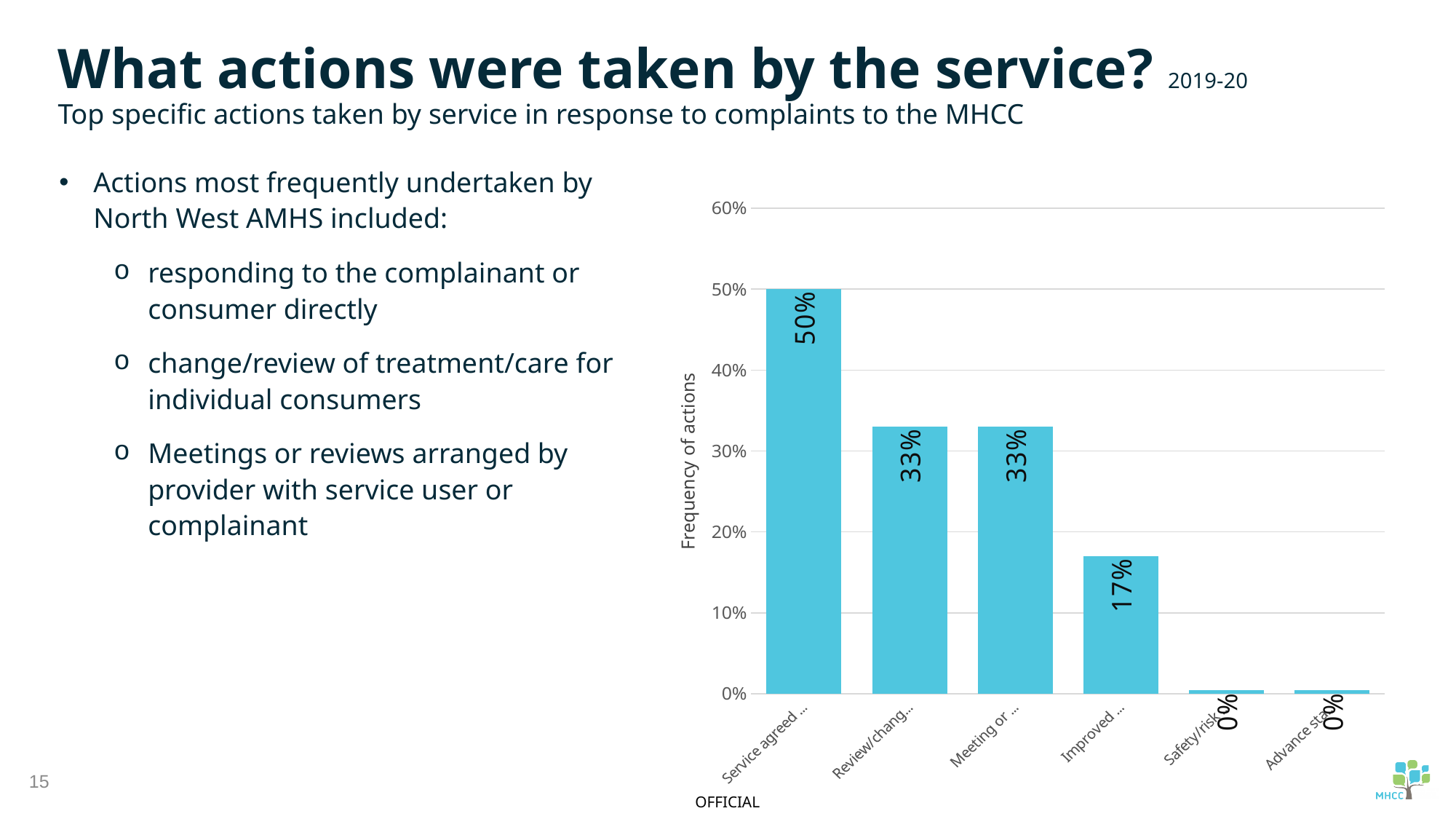
Which is larger, the value for "Review/chang..." or the value for "Improved ..."? Review/chang... What is the difference between the values for "Service agreed ..." and "Improved ..."? 33% What kind of chart is shown on the slide? bar chart What is the value for the "Service agreed ..." category? 50% What is the value for the "Safety/risk..." category? 0% What is the difference between the values for "Meeting or ..." and "Improved ..."? 16% How many categories are shown on the x axis of the chart? 6 What is the value for the "Improved ..." category? 17% Which category has the highest value? Service agreed ... Is the value for "Service agreed ..." greater or less than 40%? greater What is the value for the "Review/chang..." category? 33% What is the label of the vertical axis of the chart? Frequency of actions